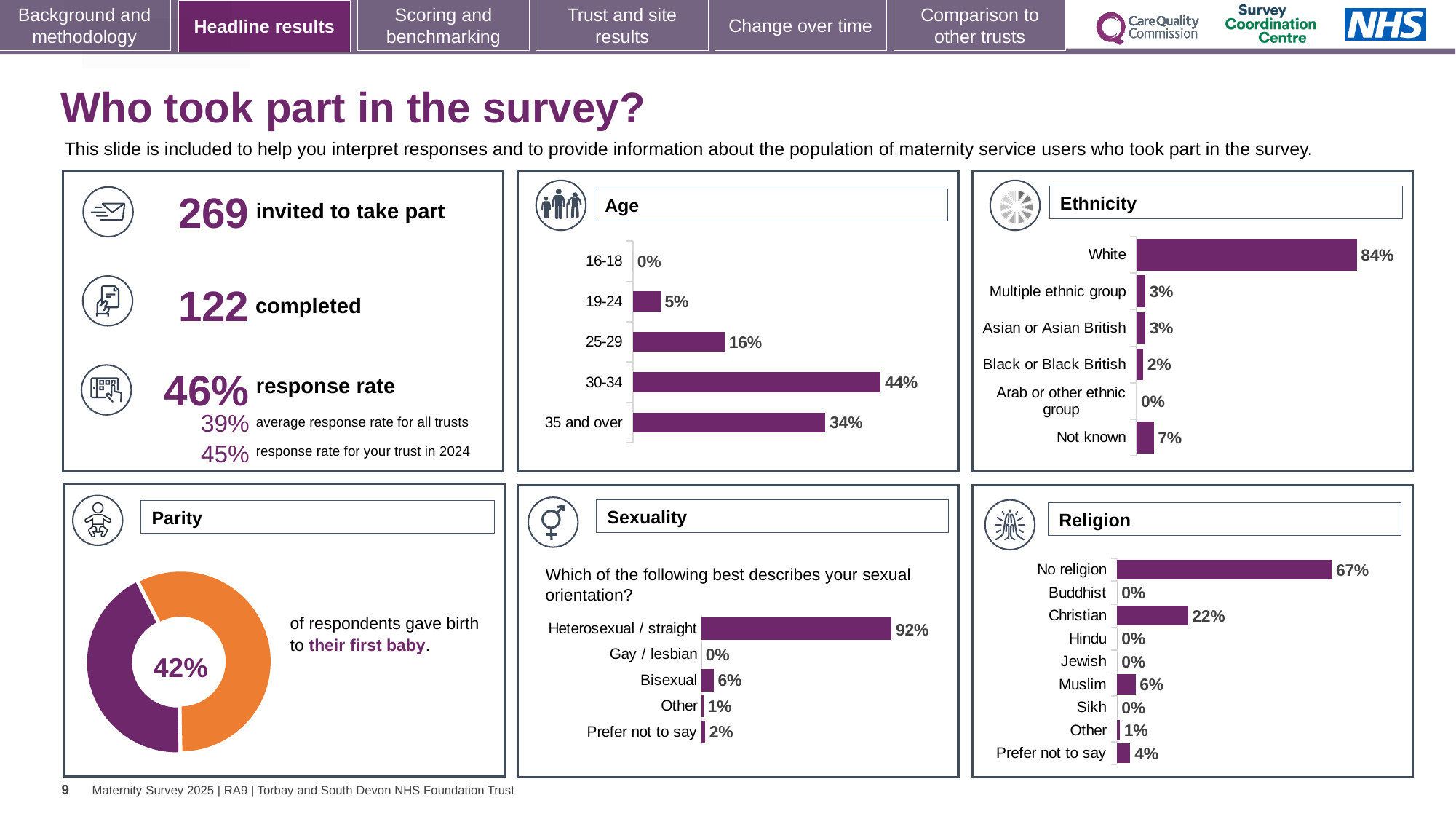
In the Age chart, what percentage of respondents were aged 30-34? 44% In the Religion chart, which category has the highest percentage? No religion In the Ethnicity chart, what percentage is shown for Not known? 7% In the Sexuality chart, what percentage of respondents described themselves as Bisexual? 6% In the Age chart, which age group has the highest percentage? 30-34 In the Age chart, what is the difference between the 30-34 and 35 and over percentages? 10% In the Sexuality chart, which is larger, Other or Prefer not to say? Prefer not to say In the Ethnicity chart, what percentage of respondents were White? 84% In the Religion chart, what percentage of respondents were Christian? 22% In the Parity chart, what percentage of respondents gave birth to their first baby? 42% What kind of chart is the Parity chart? Doughnut (pie) chart In the Ethnicity chart, how many ethnicity categories are shown? 6